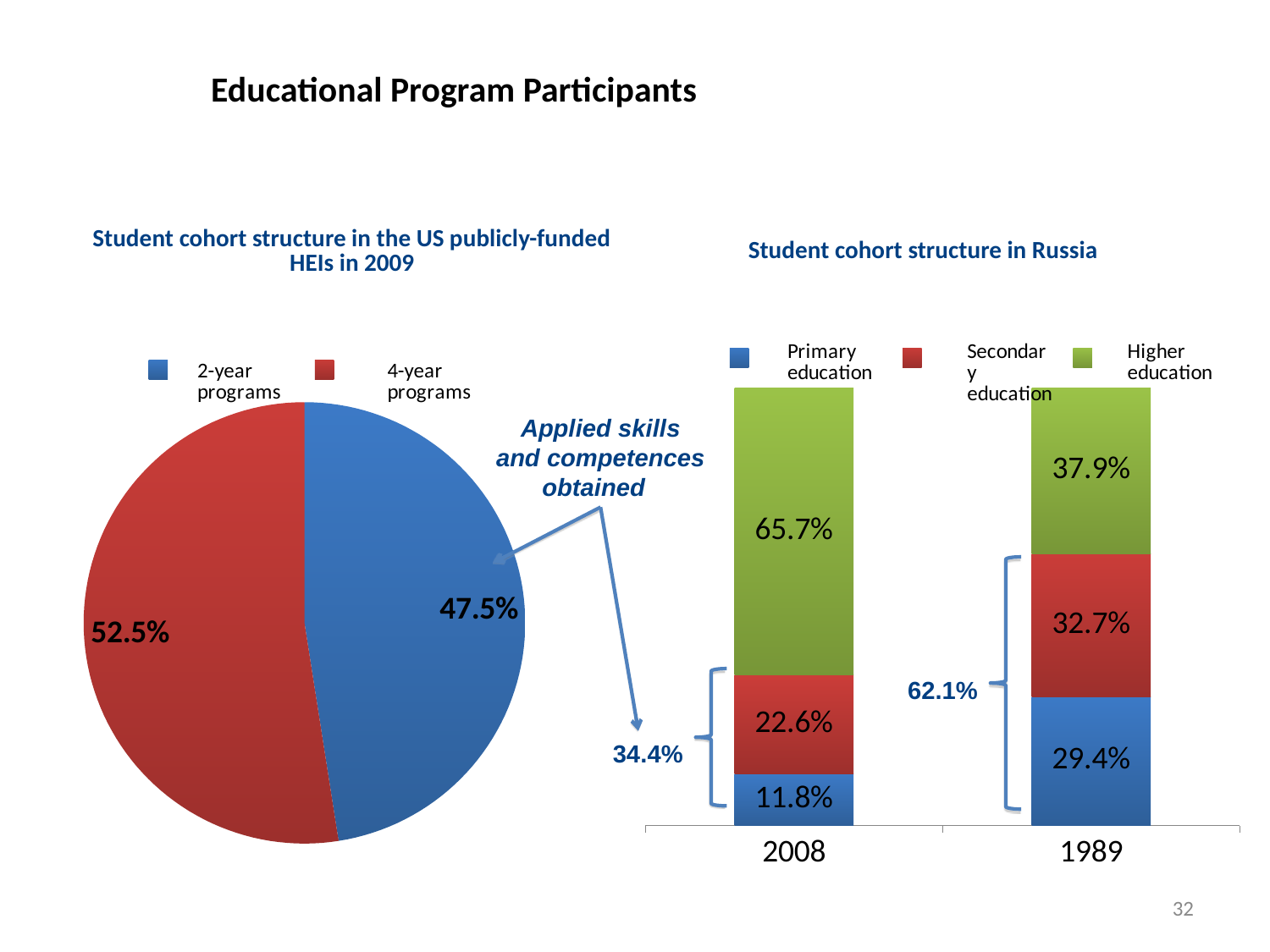
What kind of chart is 'Student cohort structure in Russia'? Stacked bar chart In the 'Student cohort structure in the US publicly-funded HEIs in 2009' chart, which program type has the larger slice? 4-year programs In the 'Student cohort structure in Russia' chart, what is the value for Primary education in 1989? 29.4% What kind of chart is 'Student cohort structure in the US publicly-funded HEIs in 2009'? Pie chart In the 'Student cohort structure in Russia' chart, what is the value for Secondary education in 2008? 22.6% In the 'Student cohort structure in Russia' chart, how many series does the legend list? 3 In the 'Student cohort structure in the US publicly-funded HEIs in 2009' chart, what share do 2-year programs have? 47.5% In the 'Student cohort structure in Russia' chart, what is the combined value of Primary and Secondary education in 2008? 34.4% In the 'Student cohort structure in Russia' chart, what is the difference between Higher education in 2008 and Higher education in 1989? 27.8% In the 'Student cohort structure in Russia' chart, what is the value for Higher education in 2008? 65.7% In the 'Student cohort structure in the US publicly-funded HEIs in 2009' chart, what share do 4-year programs have? 52.5% In the 'Student cohort structure in Russia' chart, which is larger: Secondary education in 2008 or Secondary education in 1989? Secondary education in 1989